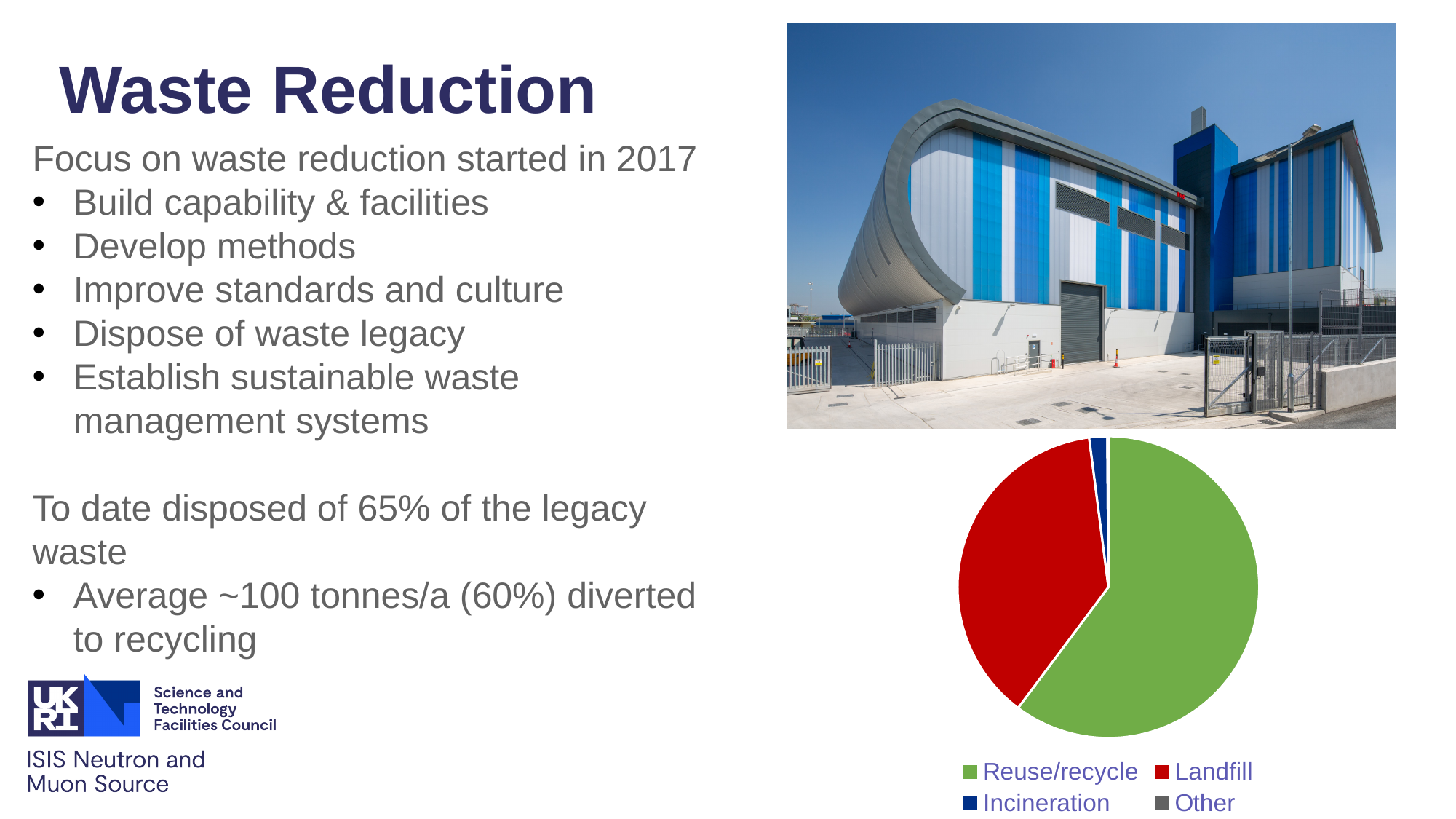
Which slice is larger in the pie chart, Incineration or Reuse/recycle? Reuse/recycle Which category is shown in green in the pie chart? Reuse/recycle What kind of chart is shown on the slide? pie chart Which slice is larger in the pie chart, Reuse/recycle or Landfill? Reuse/recycle Which slice is larger in the pie chart, Landfill or Incineration? Landfill How many categories does the legend of the pie chart list? 4 Which category has the largest slice of the pie chart? Reuse/recycle Which category is shown in red in the pie chart? Landfill